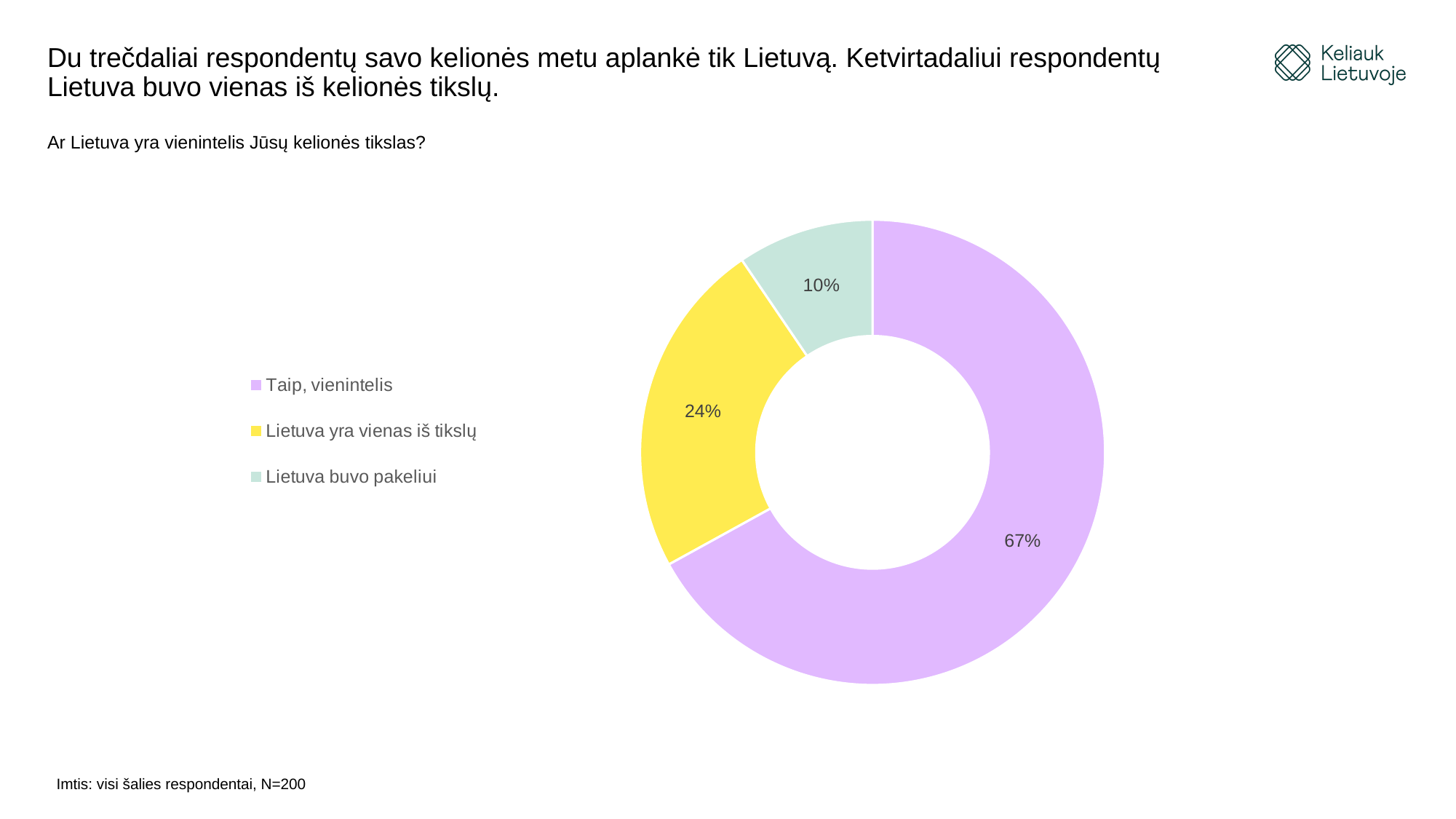
What percentage of respondents answered "Lietuva yra vienas iš tikslų"? 24% How many categories does the chart show? 3 What colour represents "Lietuva yra vienas iš tikslų" in the chart? Yellow What kind of chart is shown on the slide? Pie chart (doughnut) Which answer category has the smallest share of the chart? Lietuva buvo pakeliui What is the difference in percentage points between "Taip, vienintelis" and "Lietuva yra vienas iš tikslų"? 43 Which is larger: the share for "Lietuva yra vienas iš tikslų" or for "Lietuva buvo pakeliui"? Lietuva yra vienas iš tikslų Which answer category has the largest share of the chart? Taip, vienintelis What is the sample size stated on the slide? N=200 What is the difference in percentage points between "Lietuva yra vienas iš tikslų" and "Lietuva buvo pakeliui"? 14 What percentage of respondents answered "Taip, vienintelis"? 67% What percentage of respondents answered "Lietuva buvo pakeliui"? 10%